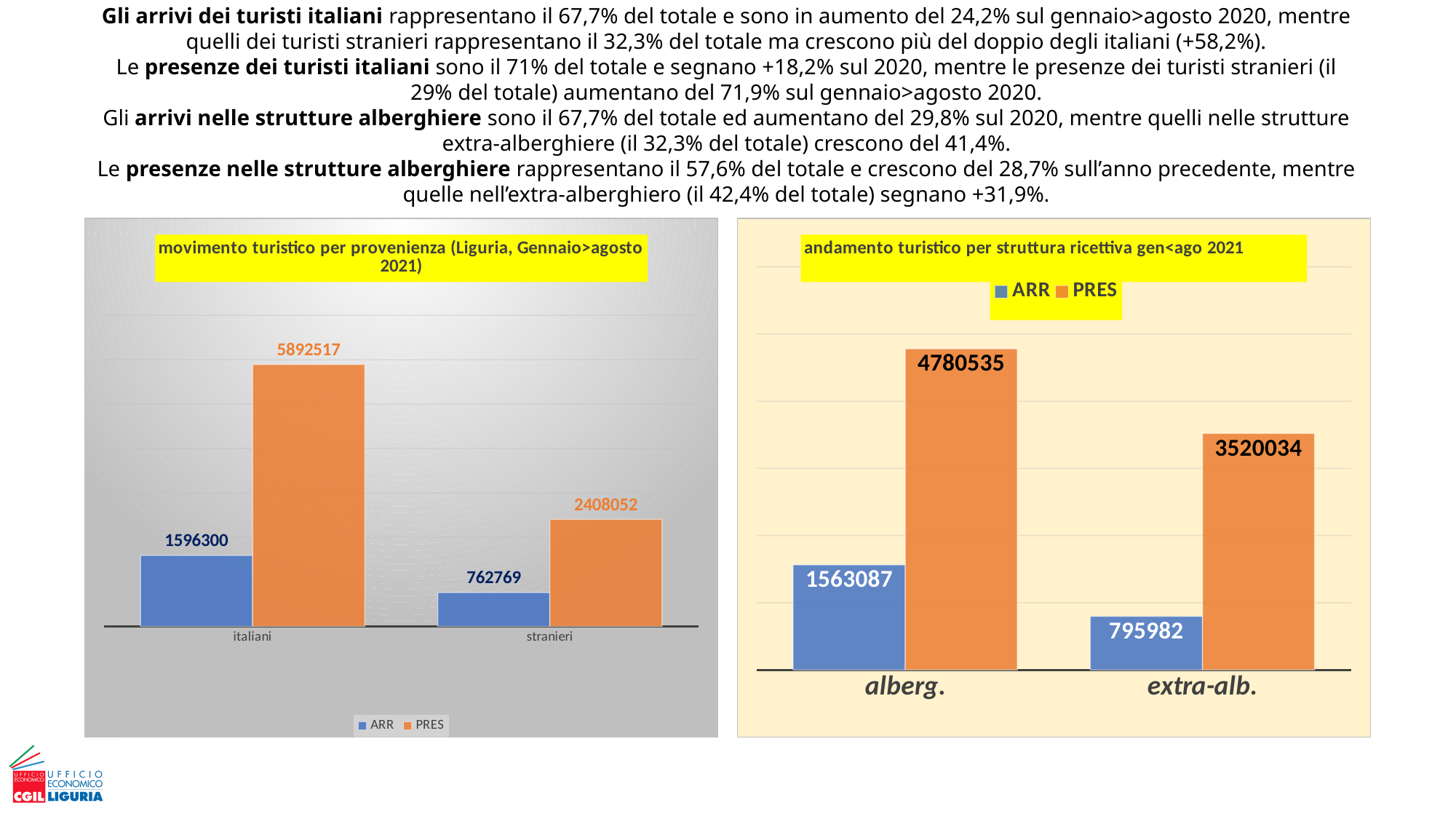
In the left chart (movimento turistico per provenienza), which category has the highest PRES value? italiani In the left chart (movimento turistico per provenienza), what is the difference between the PRES values for italiani and stranieri? 3484465 How many series does the legend of the left chart (movimento turistico per provenienza) list? 2 In the right chart (andamento turistico per struttura ricettiva), is the PRES value for alberg. larger or smaller than the PRES value for extra-alb.? larger In the right chart (andamento turistico per struttura ricettiva), what is the PRES value for alberg.? 4780535 In the right chart (andamento turistico per struttura ricettiva), which category has the lowest ARR value? extra-alb. In the left chart (movimento turistico per provenienza), what is the ARR value for italiani? 1596300 In the left chart (movimento turistico per provenienza), what is the PRES value for stranieri? 2408052 What kind of chart is the right chart (andamento turistico per struttura ricettiva)? bar chart How many categories are shown on the x axis of the left chart (movimento turistico per provenienza)? 2 In the right chart (andamento turistico per struttura ricettiva), what is the difference between the ARR values for alberg. and extra-alb.? 767105 In the right chart (andamento turistico per struttura ricettiva), what is the ARR value for extra-alb.? 795982